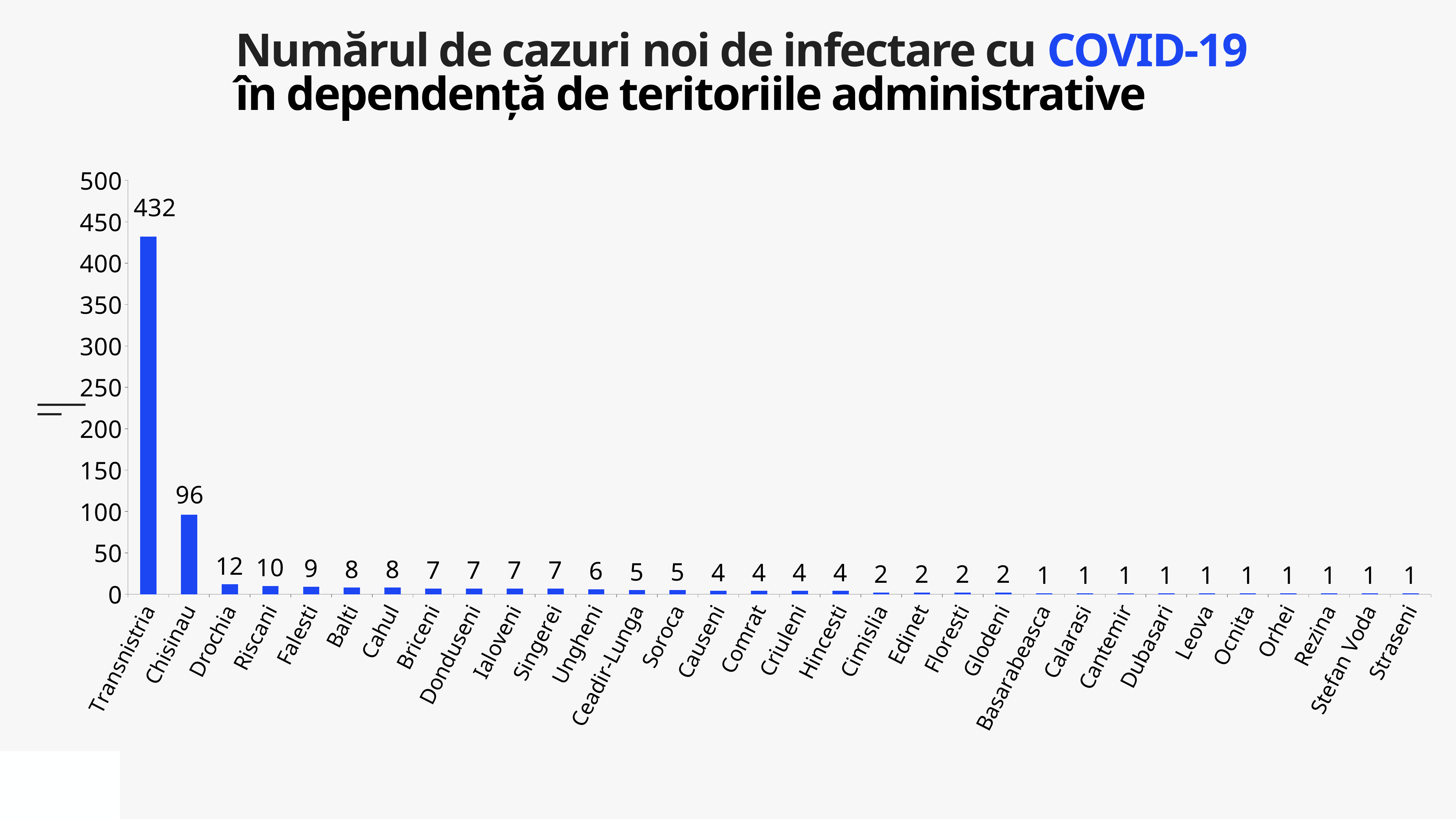
What is the difference between the values for Drochia and Riscani? 2 What kind of chart is shown on the slide? bar chart Is the value for Transnistria greater or less than 400? greater What is the value for Chisinau? 96 Which is larger, the value for Chisinau or the value for Drochia? Chisinau What is the difference between the values for Transnistria and Chisinau? 336 What is the value for Drochia? 12 Which territory has the highest number of new cases? Transnistria How many territories are shown on the x axis? 32 What is the value for Transnistria? 432 What is the value for Ungheni? 6 Do the values rise or fall from left to right along the x axis? fall